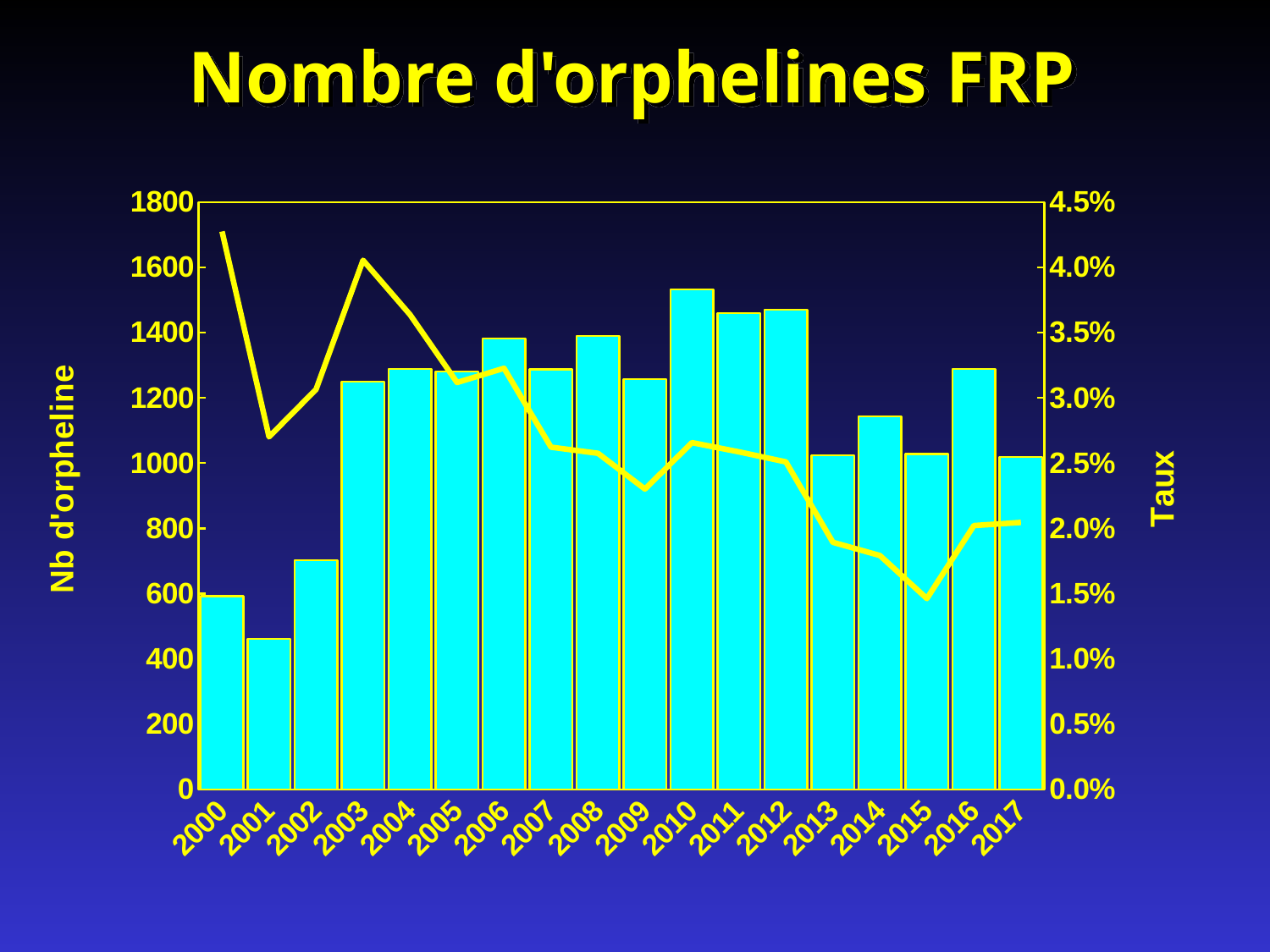
Which year has the tallest bar for the number of orphelines? 2010 How many years are shown along the x axis? 18 In which year is the Taux line at its highest point? 2000 What is the title of the chart? Nombre d'orphelines FRP Is the number of orphelines in 2010 greater or less than 1400? greater Does the Taux line generally rise or fall from 2003 to 2015? fall Is the Taux value for 2015 greater or less than 2.0%? less Is the number of orphelines in 2001 greater or less than 600? less What kind of chart is shown on the slide? A combined bar and line chart In which year is the Taux line at its lowest point? 2015 Which year has the shortest bar for the number of orphelines? 2001 Which year has the larger number of orphelines, 2002 or 2003? 2003